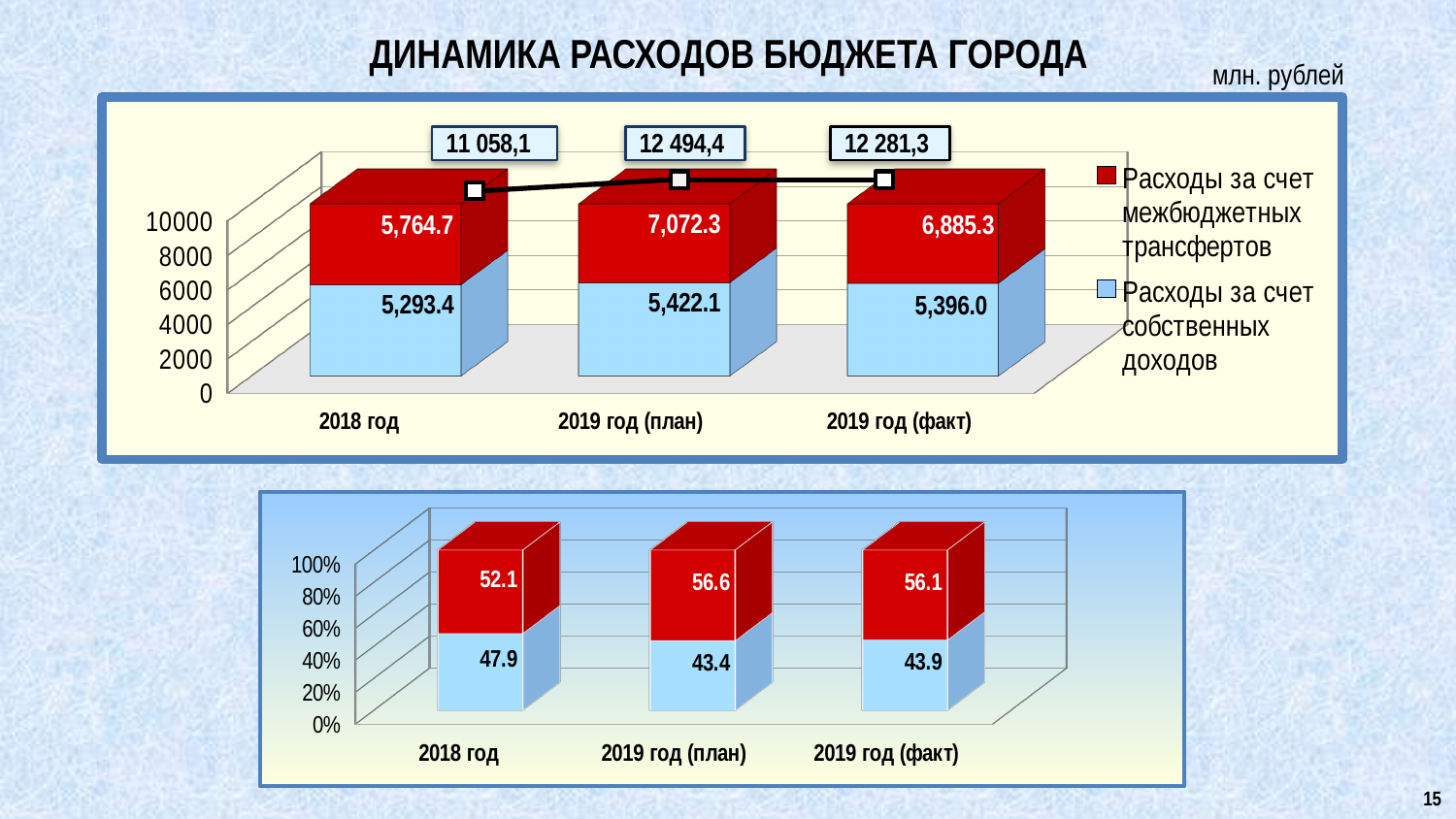
In the top chart, what is the value for Расходы за счет собственных доходов in 2018 год? 5,293.4 In the bottom chart, what is the value of the red segment for 2019 год (факт)? 56.1 In the top chart, what is the difference between Расходы за счет межбюджетных трансфертов in 2019 год (план) and 2019 год (факт)? 187.0 What kind of chart is the bottom chart? Stacked bar chart In the bottom chart, which is larger: the blue segment for 2018 год or the blue segment for 2019 год (план)? 2018 год In the top chart, which category has the lowest value for Расходы за счет собственных доходов? 2018 год In the top chart, how many categories are shown on the x axis? 3 In the top chart, what is the value for Расходы за счет межбюджетных трансфертов in 2019 год (план)? 7,072.3 In the top chart, which category has the highest value for Расходы за счет межбюджетных трансфертов? 2019 год (план) In the top chart, what is the total shown above the bar for 2019 год (факт)? 12 281,3 In the top chart, how many series does the legend list? 2 What unit is stated at the top right of the slide for the top chart? млн. рублей